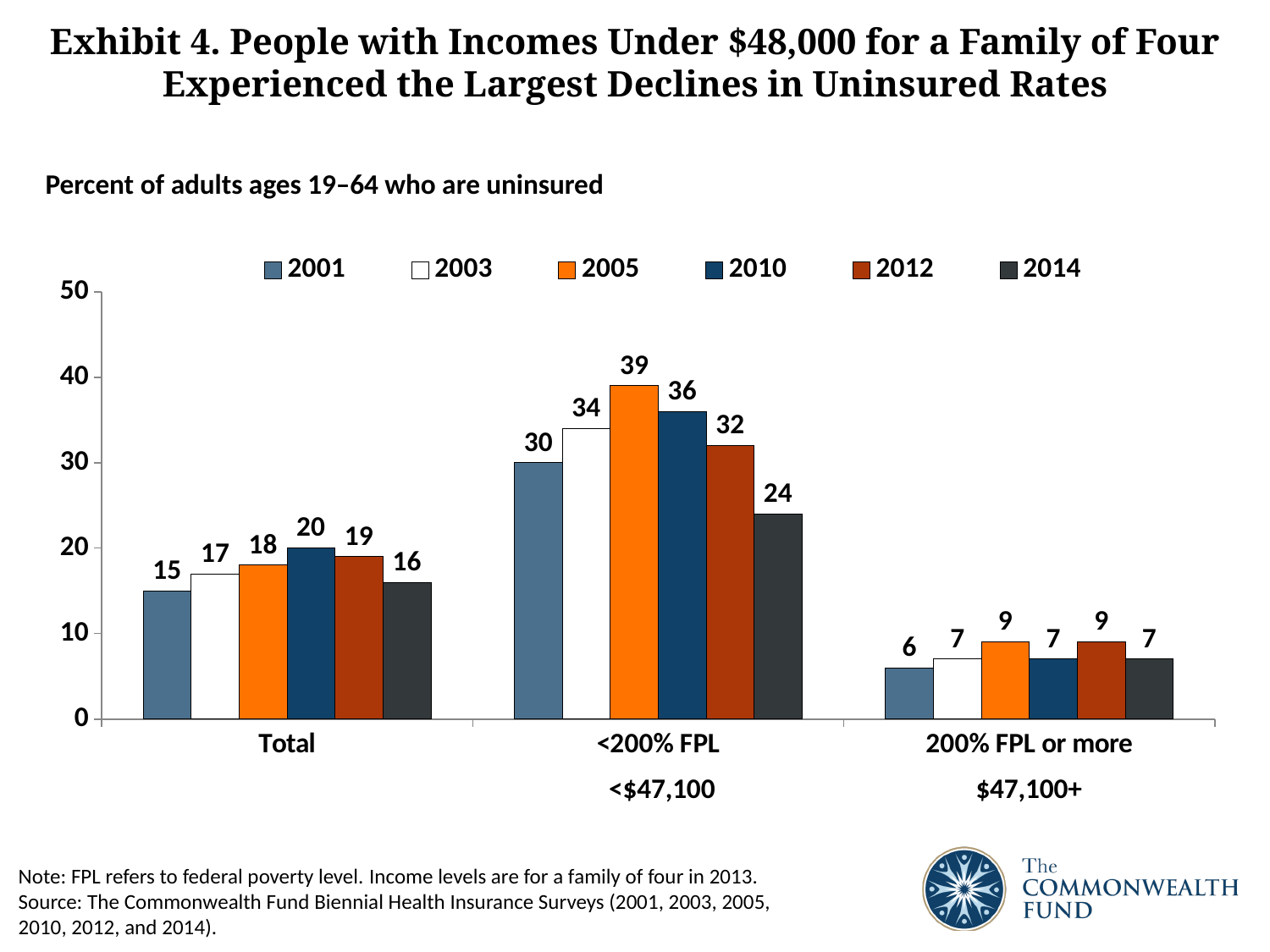
How many series does the legend list? 6 What is the difference between the 2005 and 2014 values for the <200% FPL group? 15 Which is larger: the 2012 value for <200% FPL or the 2012 value for Total? <200% FPL What is the uninsured rate for the <200% FPL group in 2005? 39 What kind of chart is shown on the slide? Bar chart What is the value for the 200% FPL or more group in 2001? 6 Which year has the lowest value in the Total category? 2001 How many income categories are shown on the x axis? 3 Is the 2010 value for the <200% FPL group greater or less than 30? greater What is the difference between the 2010 and 2014 values in the Total category? 4 Which year has the highest uninsured rate for the <200% FPL group? 2005 What is the value for the Total category in 2014? 16